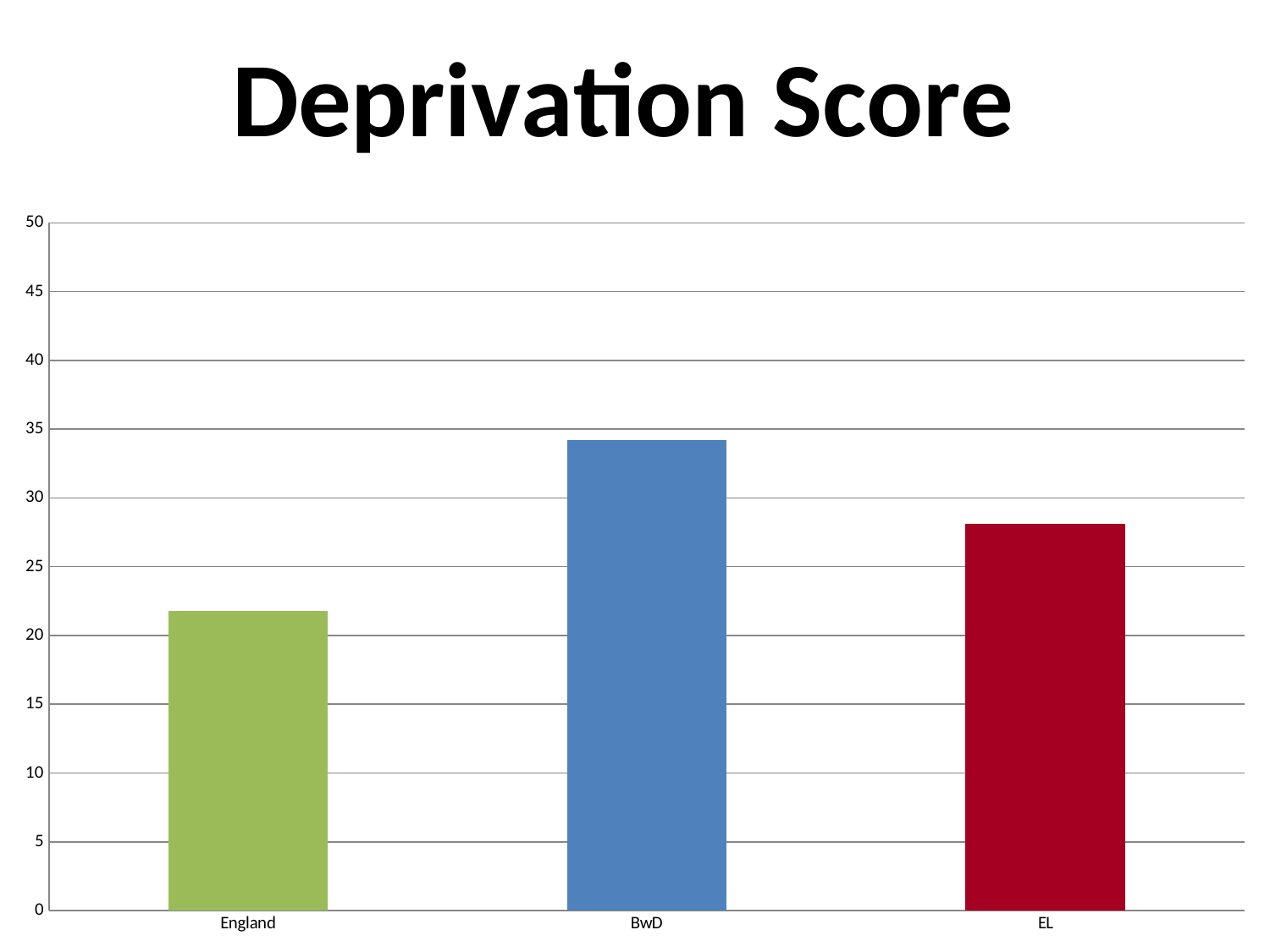
What is the title of the slide? Deprivation Score Which has a higher deprivation score, EL or England? EL Which category has the lowest deprivation score? England Is the value for England greater or less than 25? less Which has a higher deprivation score, BwD or EL? BwD Is the value for EL greater or less than 25? greater Is the value for England greater or less than 20? greater How many categories are shown on the x axis? 3 Which category has the highest deprivation score? BwD What kind of chart is shown on the slide? Bar chart